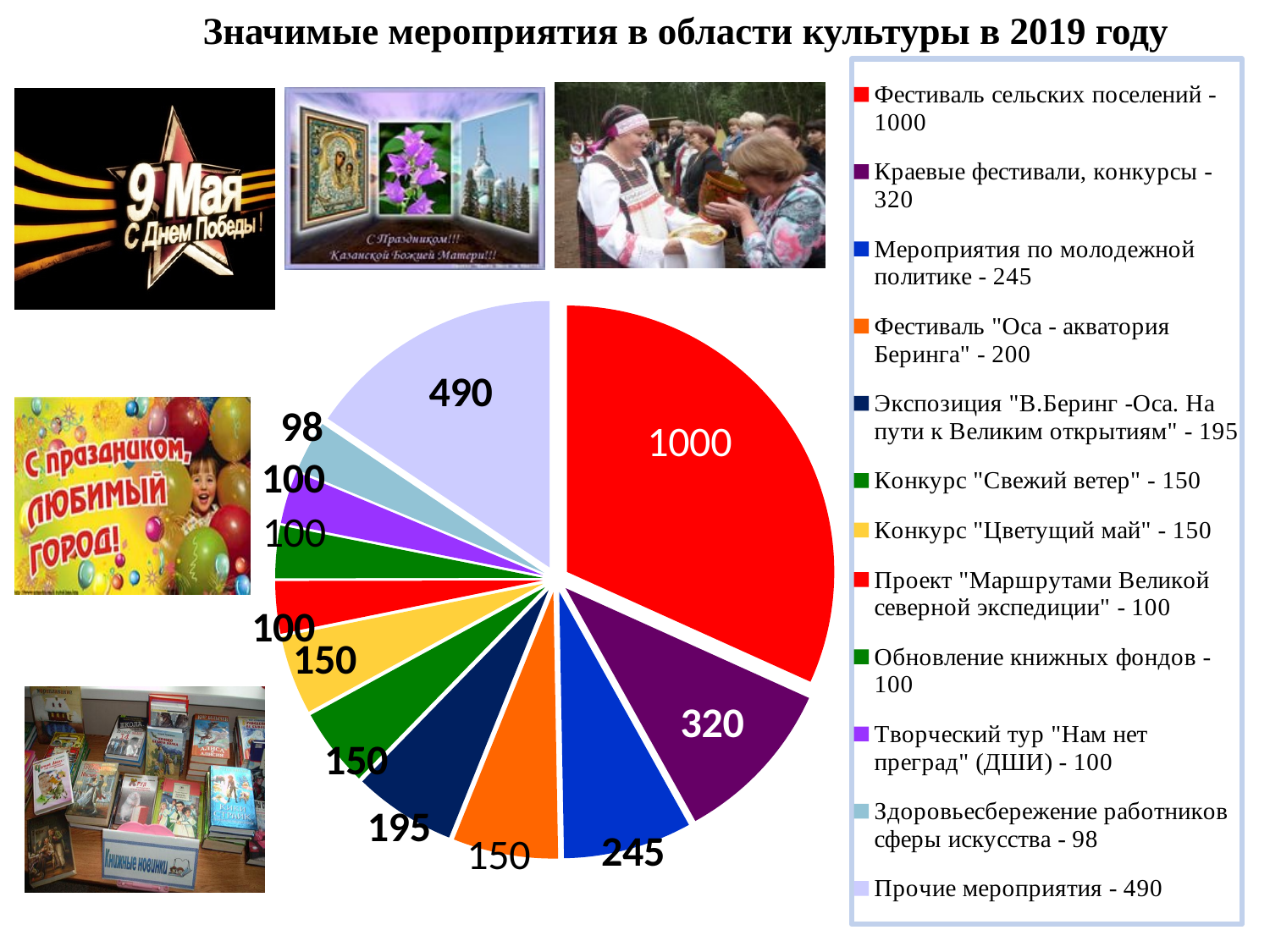
What is the value for "Экспозиция "В.Беринг - Оса. На пути к Великим открытиям""? 195 What colour is the largest slice of the pie chart? red What is the value for "Прочие мероприятия"? 490 What is the difference between the values for "Прочие мероприятия" and "Мероприятия по молодежной политике"? 245 What is the value for "Мероприятия по молодежной политике"? 245 Which category has the smallest slice in the pie chart? Здоровьесбережение работников сферы искусства What kind of chart is shown on the slide? pie chart How many categories does the pie chart have? 12 Which is larger: "Краевые фестивали, конкурсы" or "Прочие мероприятия"? Прочие мероприятия What is the difference between the values for "Фестиваль сельских поселений" and "Краевые фестивали, конкурсы"? 680 What is the value for "Краевые фестивали, конкурсы"? 320 Which category has the largest slice in the pie chart? Фестиваль сельских поселений